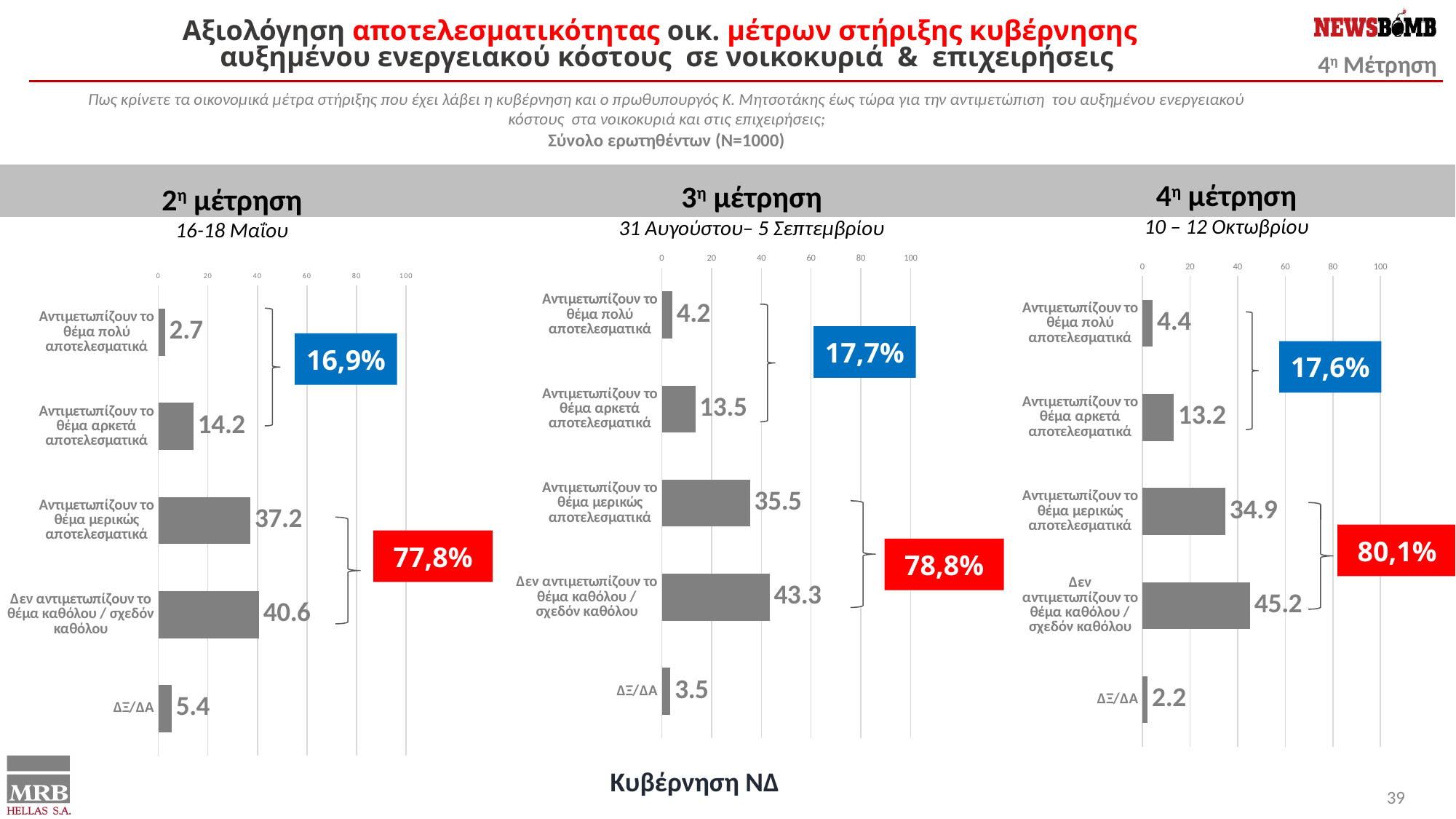
In the 3η μέτρηση chart, what is the value for 'ΔΞ/ΔΑ'? 3.5 In the 4η μέτρηση chart, what is the value for 'Αντιμετωπίζουν το θέμα πολύ αποτελεσματικά'? 4.4 In the 4η μέτρηση chart, which category has the highest value? Δεν αντιμετωπίζουν το θέμα καθόλου / σχεδόν καθόλου How many categories does the 3η μέτρηση chart show? 5 In the 2η μέτρηση chart, what is the value for 'Δεν αντιμετωπίζουν το θέμα καθόλου / σχεδόν καθόλου'? 40.6 What percentage is shown in the red box on the 4η μέτρηση chart? 80,1% In the 3η μέτρηση chart, what is the value for 'Αντιμετωπίζουν το θέμα μερικώς αποτελεσματικά'? 35.5 In the 2η μέτρηση chart, is the value for 'Αντιμετωπίζουν το θέμα μερικώς αποτελεσματικά' greater or less than 20? greater In the 3η μέτρηση chart, what is the difference between 'Δεν αντιμετωπίζουν το θέμα καθόλου / σχεδόν καθόλου' and 'Αντιμετωπίζουν το θέμα μερικώς αποτελεσματικά'? 7.8 What kind of chart is the 4η μέτρηση chart? bar chart In the 2η μέτρηση chart, which category has the lowest value? Αντιμετωπίζουν το θέμα πολύ αποτελεσματικά In the 4η μέτρηση chart, which is larger: 'Αντιμετωπίζουν το θέμα αρκετά αποτελεσματικά' or 'ΔΞ/ΔΑ'? Αντιμετωπίζουν το θέμα αρκετά αποτελεσματικά